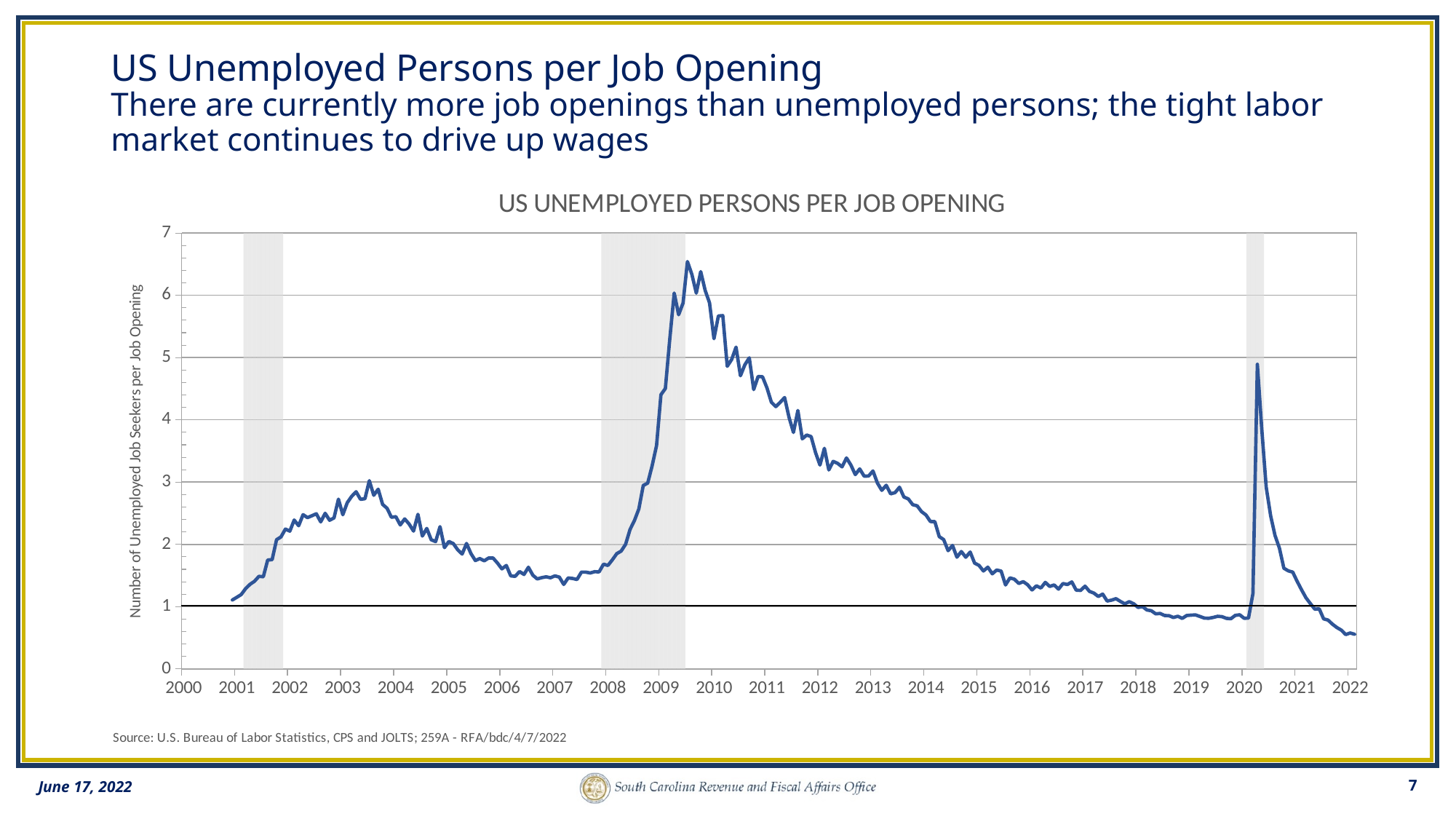
Does the line generally rise or fall between 2001 and 2003? rise Is the value at the 2020 spike greater or less than 4? greater Which peak is higher, the one around 2009 or the one in 2020? 2009 Does the line generally rise or fall between 2010 and 2018? fall What is the title of the chart? US UNEMPLOYED PERSONS PER JOB OPENING What is the label on the vertical axis of the chart? Number of Unemployed Job Seekers per Job Opening Is the peak value reached around 2003 greater or less than 4? less Is the peak value reached around 2009 greater or less than 6? greater Which peak is higher, the one around 2003 or the one around 2009? 2009 What kind of chart is shown on the slide? line chart In which year does the line reach its highest value? 2009